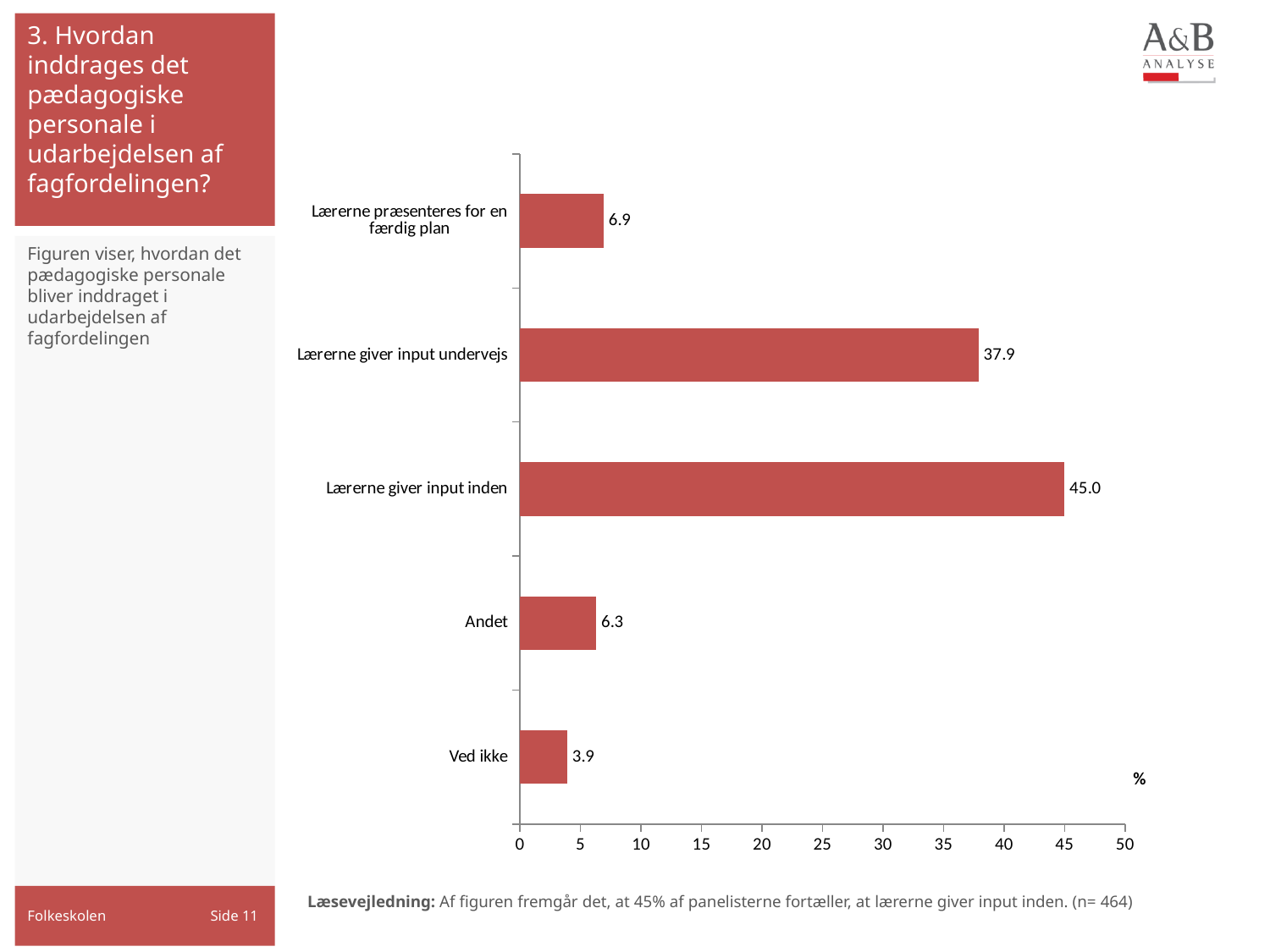
What is the value for "Lærerne giver input inden"? 45.0 Is the value for "Lærerne giver input undervejs" greater or less than 35? greater What is the difference between the values for "Lærerne giver input inden" and "Lærerne giver input undervejs"? 7.1 What is the value for "Lærerne præsenteres for en færdig plan"? 6.9 Which category has the lowest value? Ved ikke Which category has the highest value? Lærerne giver input inden What is the value for "Lærerne giver input undervejs"? 37.9 What is the value for "Ved ikke"? 3.9 How many categories are shown in the chart? 5 What unit is indicated on the horizontal axis of the chart? % What kind of chart is shown on the slide? bar chart Which is larger, the value for "Andet" or the value for "Lærerne præsenteres for en færdig plan"? Lærerne præsenteres for en færdig plan